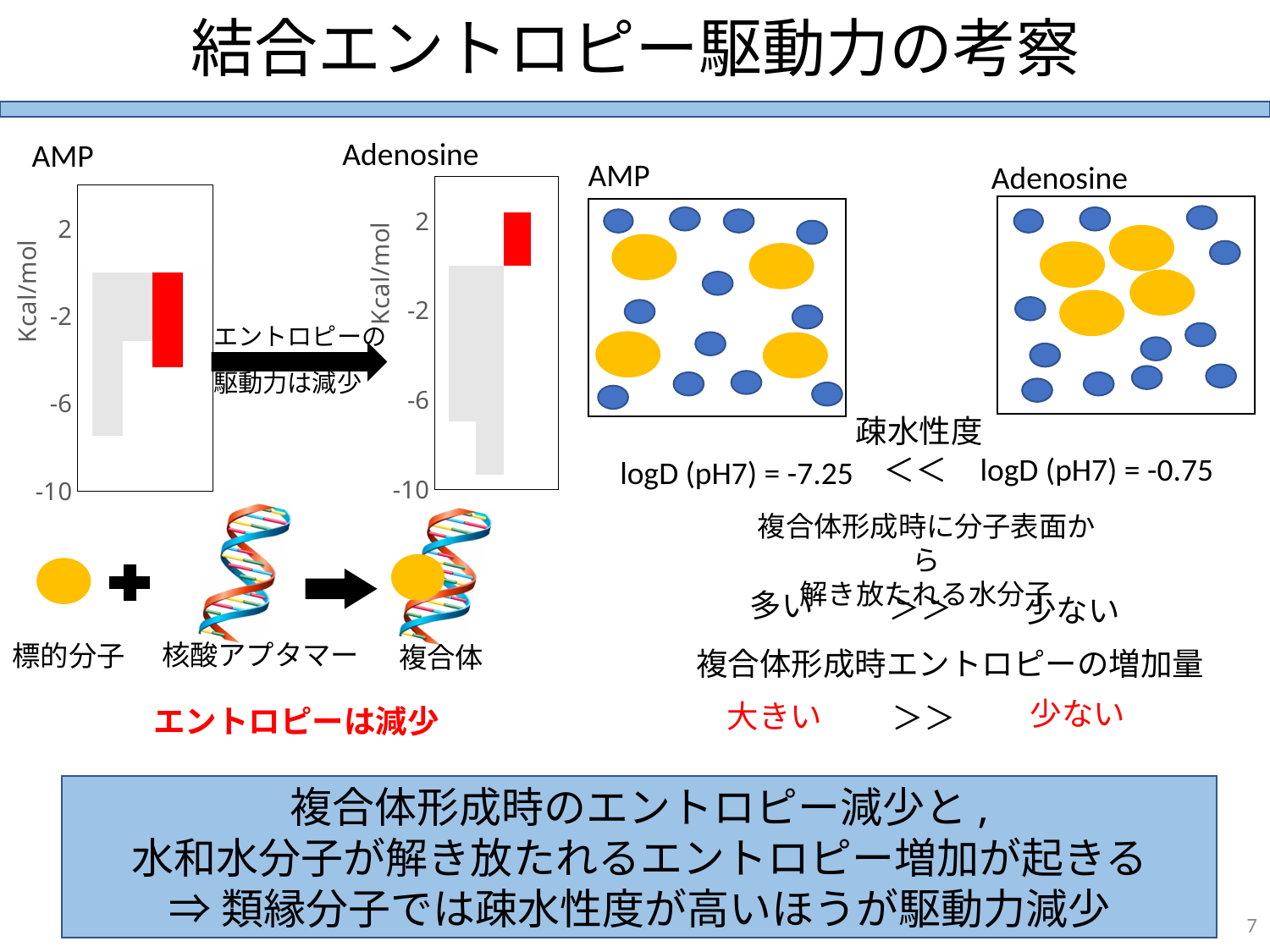
What is the y-axis label on the AMP bar chart? Kcal/mol Which chart has a red bar with a larger value, the AMP chart or the Adenosine chart? Adenosine How many bar charts are shown on the slide? 2 In the Adenosine bar chart, is the value of the lowest gray bar greater or less than -6? less What kind of chart is the AMP chart on the left of the slide? bar chart In the AMP bar chart, is the value of the red bar greater or less than -2? less What is the lowest tick value shown on the y-axis of the Adenosine bar chart? -10 In the Adenosine bar chart, is the red bar positive or negative? positive In the AMP bar chart, is the red bar's value greater or less than 2? less